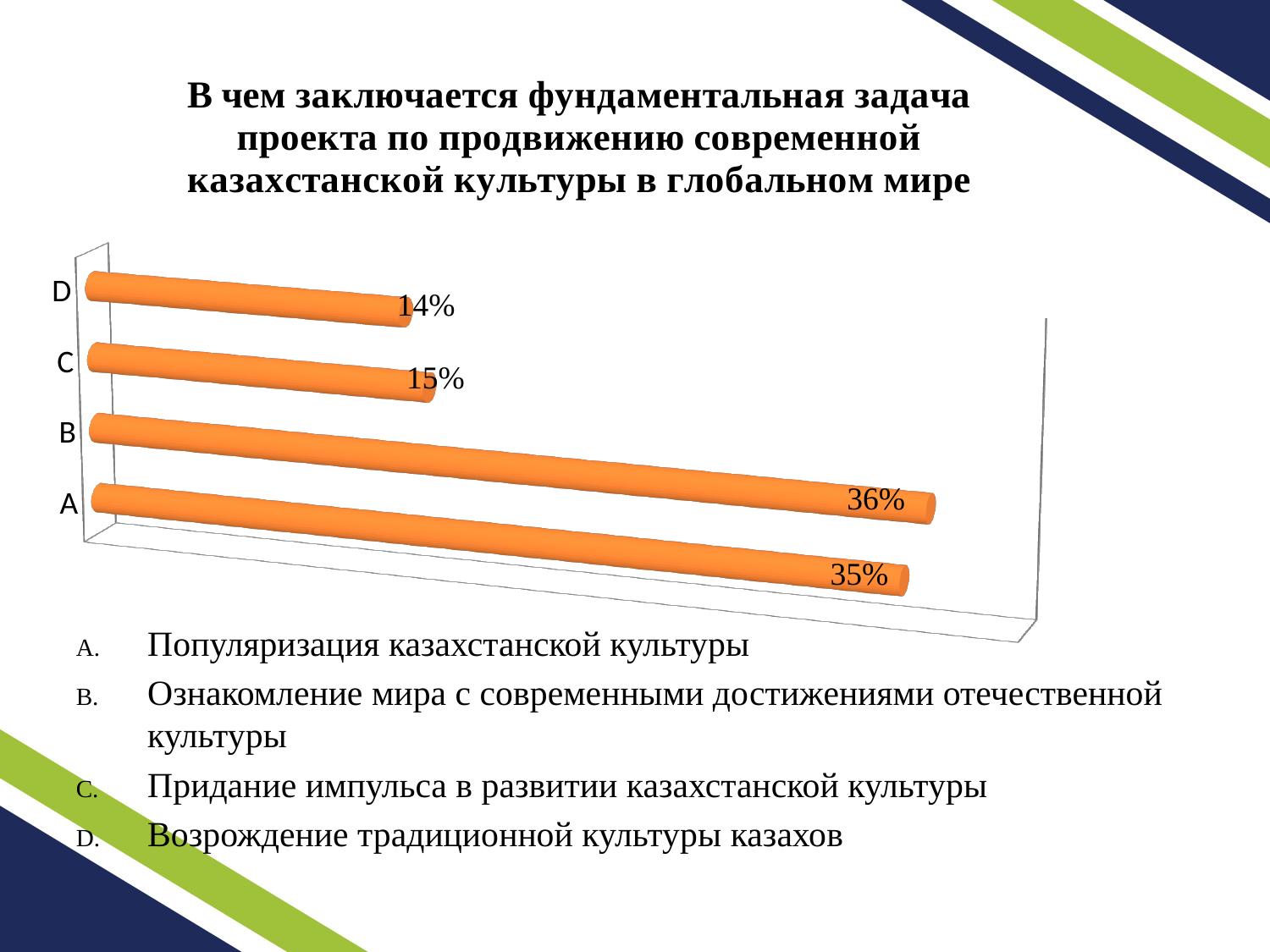
What is the value for category D? 14% How many categories are shown in the chart? 4 Which category has the lowest value? D What is the difference between the values for B and D? 22% What colour are the bars in the chart? Orange What kind of chart is shown on the slide? Bar chart What is the value for category C? 15% Which is larger, the value for A or the value for C? A Which category has the highest value? B What is the value for category B? 36% What is the value for category A? 35% What is the difference between the values for A and C? 20%